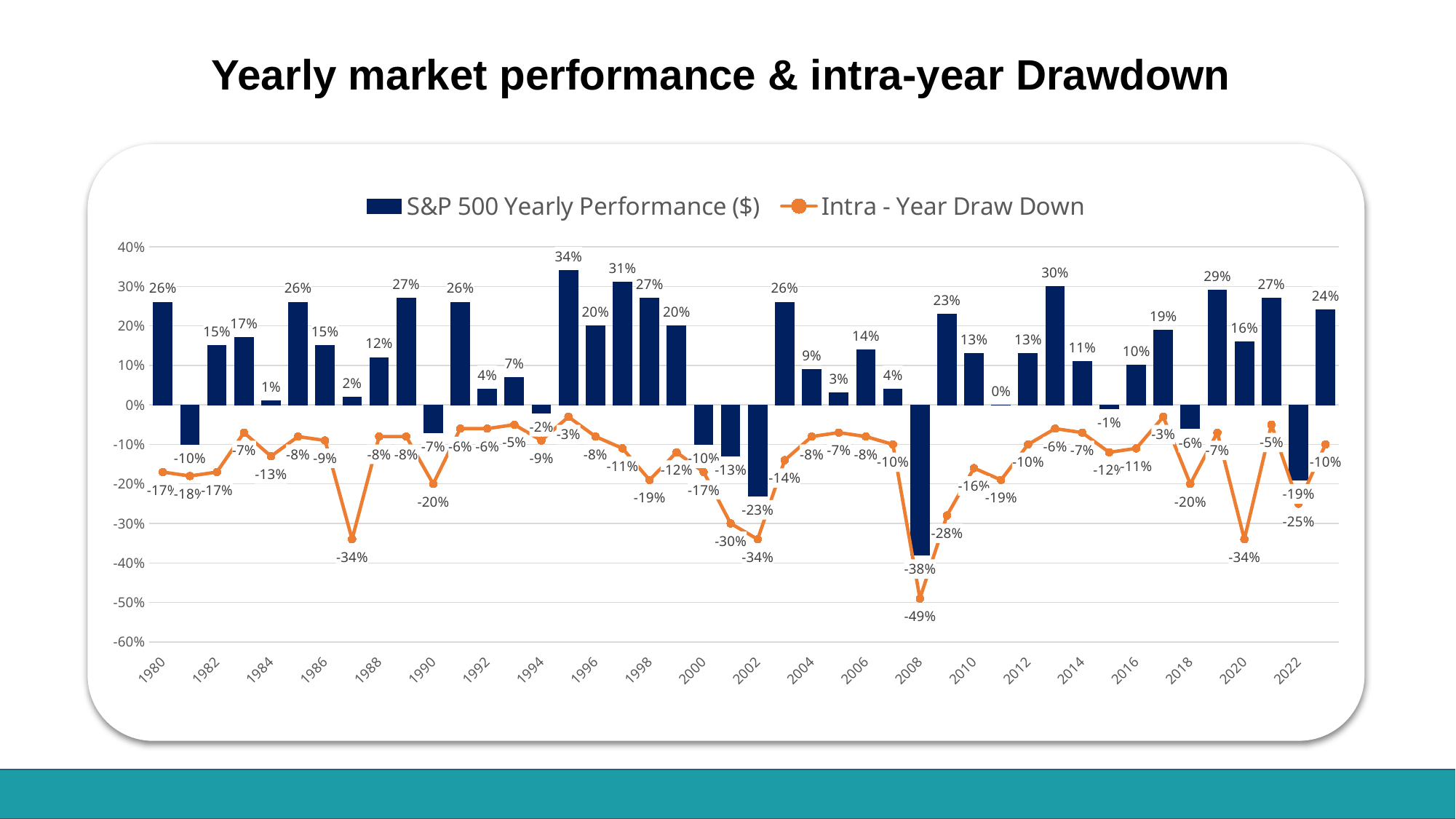
What is the S&P 500 yearly performance for 1980? 26% Which is larger, the S&P 500 yearly performance for 2020 or for 2022? 2020 Which year has the most negative intra-year drawdown? 2008 How many series does the legend list? 2 What is the intra-year drawdown value for 2020? -34% What kind of chart is shown on the slide? A combination bar and line chart What is the intra-year drawdown value for 2008? -49% What is the difference in percentage points between the S&P 500 yearly performance for 1980 and for 2022? 45 percentage points What is the S&P 500 yearly performance for 2022? -19% Which year has the lowest S&P 500 yearly performance? 2008 What is the S&P 500 yearly performance for 2008? -38% What is the highest S&P 500 yearly performance value shown on the chart? 34%